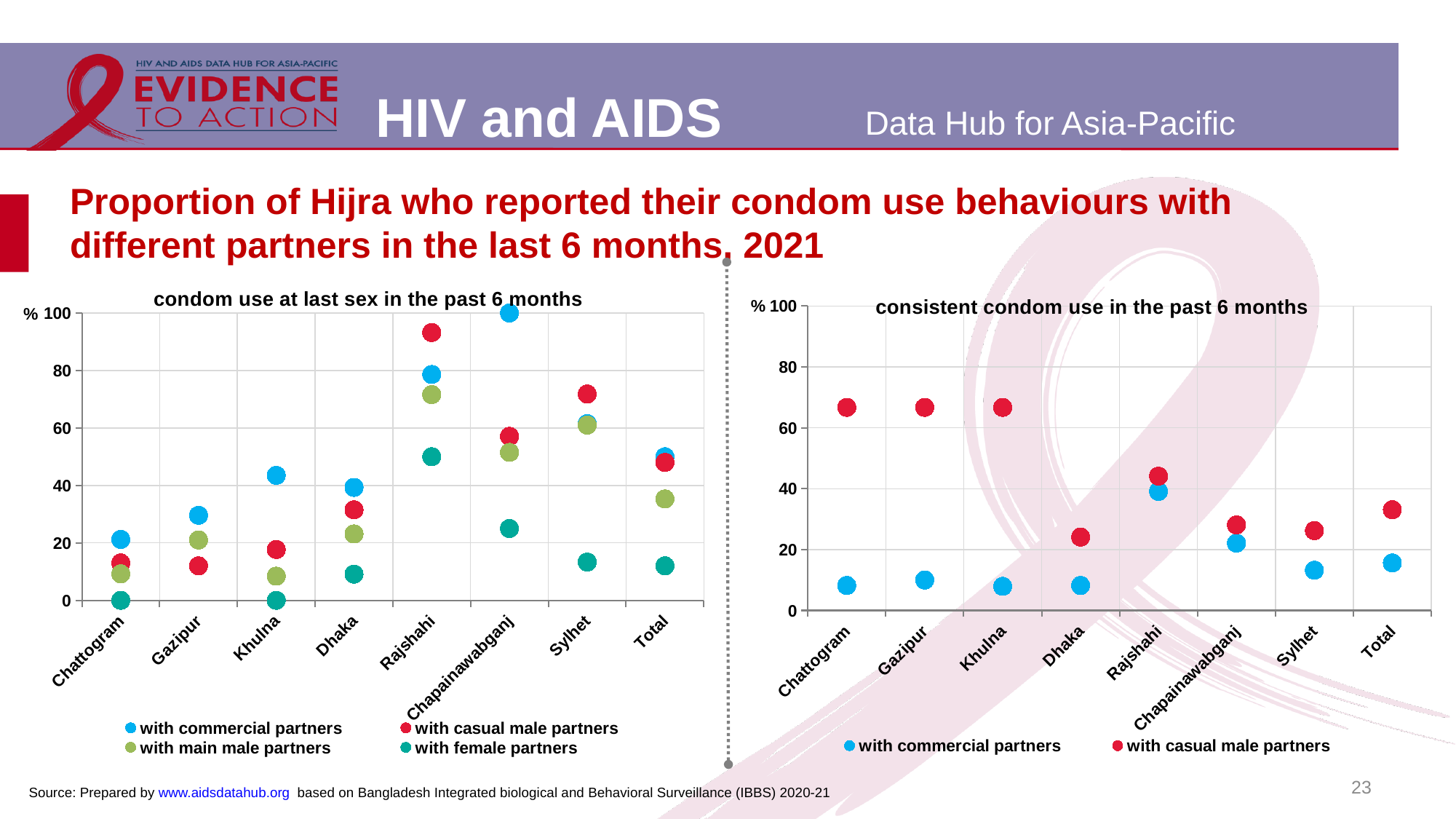
What kind of chart is the left chart titled 'condom use at last sex in the past 6 months'? scatter chart In the right chart 'consistent condom use in the past 6 months', which category has the highest value for the 'with commercial partners' series? Rajshahi In the right chart 'consistent condom use in the past 6 months', for Total, which is larger: the value with commercial partners or with casual male partners? with casual male partners In the left chart 'condom use at last sex in the past 6 months', which category has the highest value for the 'with commercial partners' series? Chapainawabganj In the left chart 'condom use at last sex in the past 6 months', for Khulna, which is larger: the value with commercial partners or with casual male partners? with commercial partners How many categories are shown on the x axis of the left chart 'condom use at last sex in the past 6 months'? 8 In the right chart 'consistent condom use in the past 6 months', is the value for Sylhet with commercial partners greater or less than 20? less How many series does the legend of the right chart 'consistent condom use in the past 6 months' list? 2 In the left chart 'condom use at last sex in the past 6 months', is the value for Chattogram with female partners greater or less than 20? less In the right chart 'consistent condom use in the past 6 months', is the value for Chattogram with casual male partners greater or less than 60? greater How many series does the legend of the left chart 'condom use at last sex in the past 6 months' list? 4